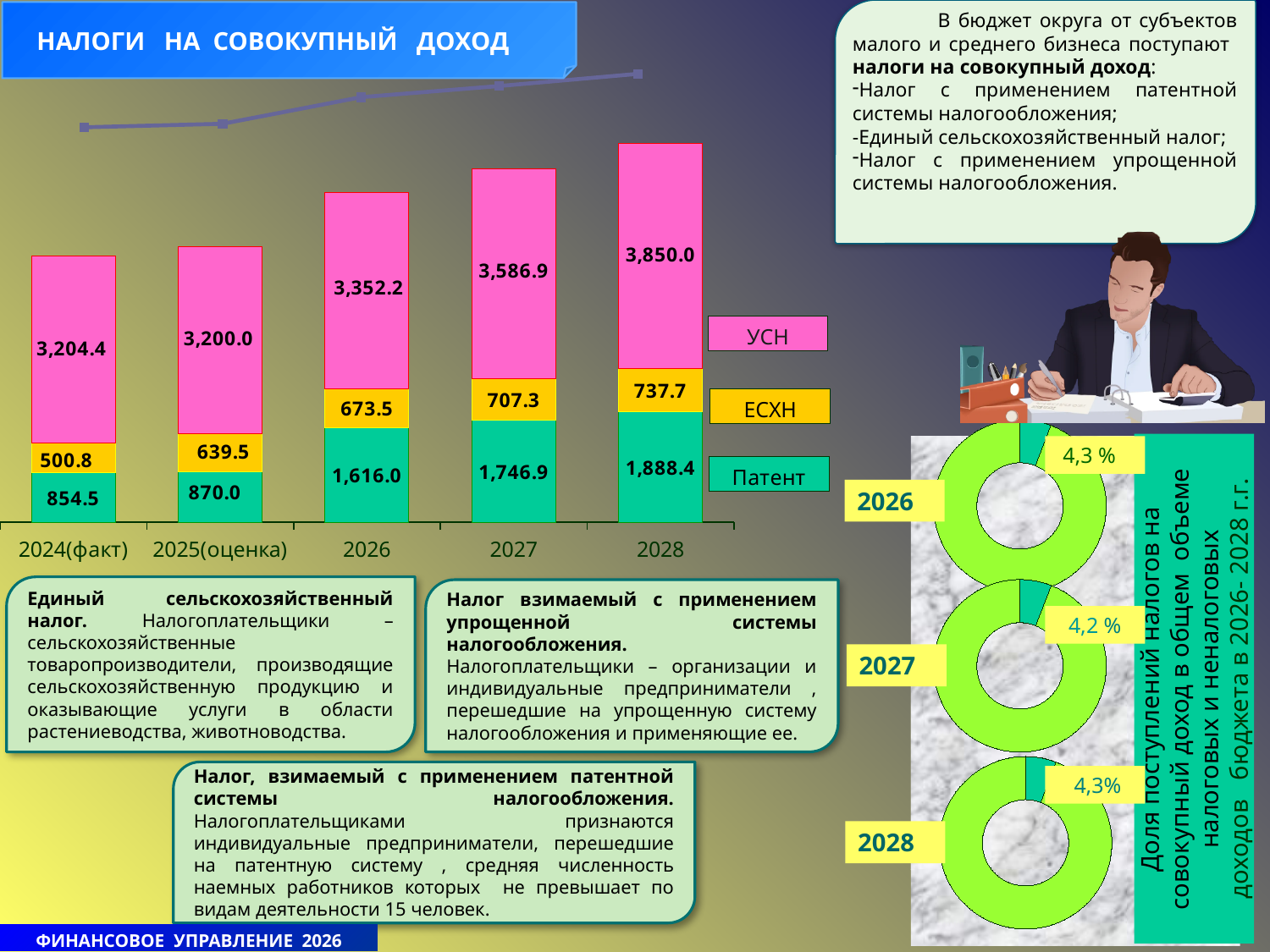
In the stacked bar chart, what is the difference between the УСН values for 2028 and 2024(факт)? 645.6 In the stacked bar chart, what is the ЕСХН value for 2027? 707.3 How many series does the legend of the stacked bar chart list? 3 In the stacked bar chart, what is the total of the stacked bar for 2028? 6,476.1 How many categories are shown on the x axis of the stacked bar chart? 5 In the stacked bar chart, what is the УСН value for 2026? 3,352.2 In the stacked bar chart, what is the Патент value for 2025(оценка)? 870.0 What kind of chart is the main chart on the left of the slide? stacked bar chart In the donut charts on the right, what share is shown for 2027? 4,2 % In the stacked bar chart, which category has the lowest ЕСХН value? 2024(факт) In the stacked bar chart, which category has the highest УСН value? 2028 In the stacked bar chart, which is larger: the Патент value for 2027 or the Патент value for 2026? 2027